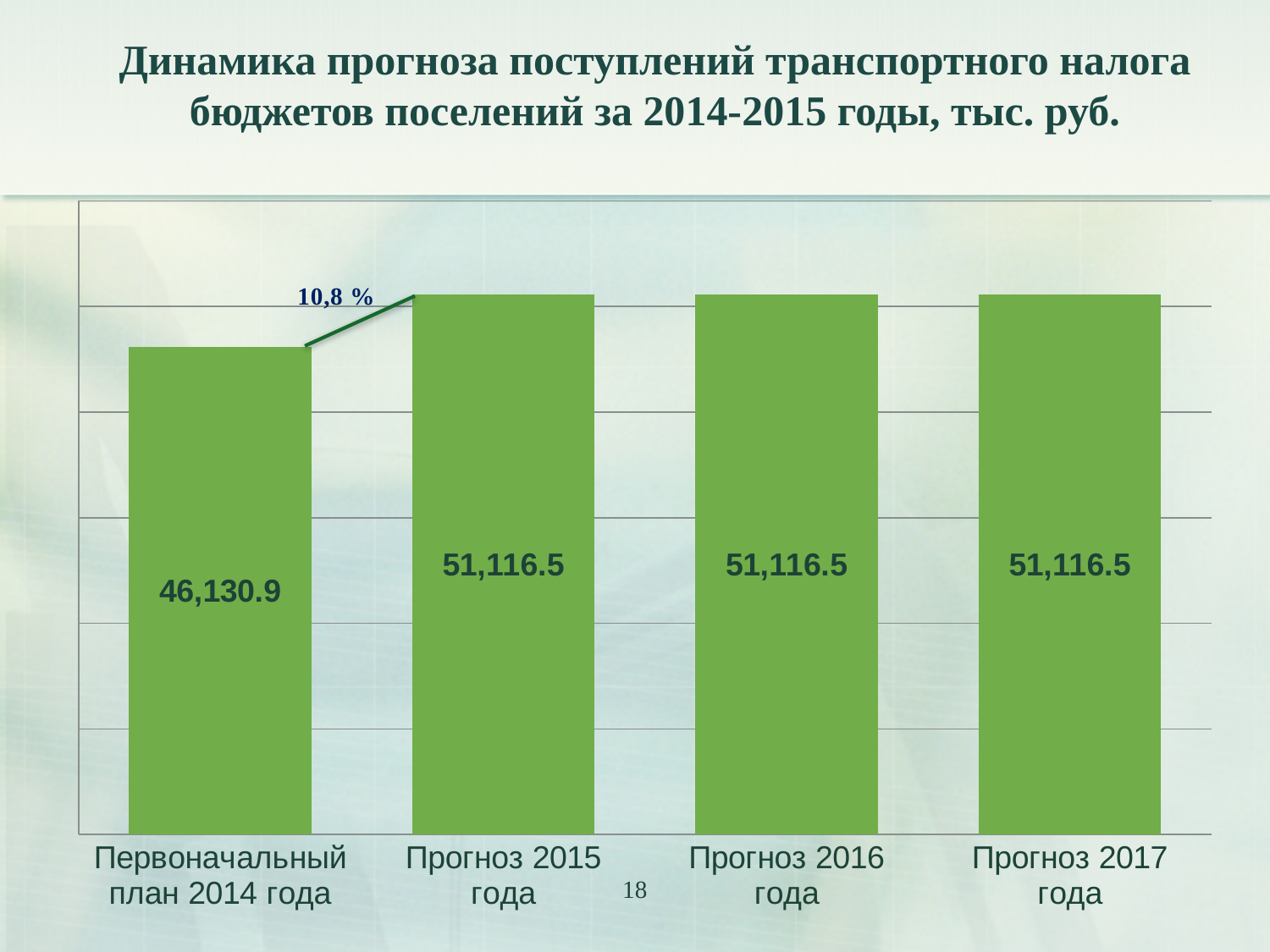
How many categories are shown on the x axis? 4 Are the values for Прогноз 2015 года, Прогноз 2016 года and Прогноз 2017 года the same or different? The same Do the values rise or fall from Первоначальный план 2014 года to Прогноз 2015 года? Rise What percentage change is annotated between the 2014 plan and the 2015 forecast? 10,8 % What kind of chart is shown on the slide? Bar chart In what units are the values on the chart given, according to the title? тыс. руб. What is the value for Первоначальный план 2014 года? 46,130.9 What is the value for Прогноз 2015 года? 51,116.5 Which category has the lowest value? Первоначальный план 2014 года What is the difference between the values for Прогноз 2015 года and Первоначальный план 2014 года? 4,985.6 What is the value for Прогноз 2017 года? 51,116.5 Which is larger, the value for Прогноз 2016 года or the value for Первоначальный план 2014 года? Прогноз 2016 года